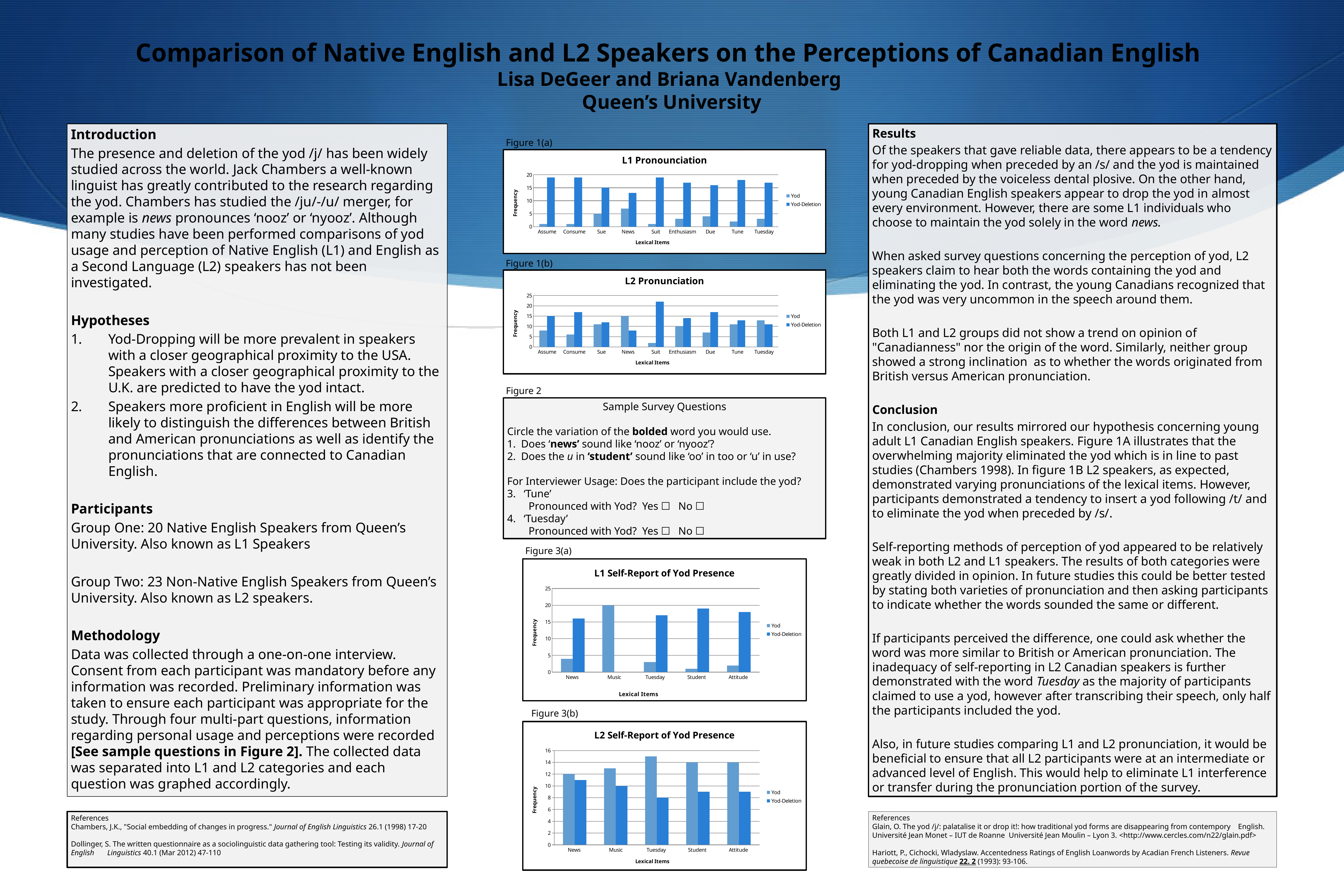
In the L1 Self-Report of Yod Presence chart, which lexical item has the highest Yod value? Music In the L1 Pronounciation chart, how many lexical items are shown on the x axis? 9 In the L2 Pronunciation chart, which lexical item has the highest Yod-Deletion value? Suit In the L1 Self-Report of Yod Presence chart, is the Yod-Deletion value for Student greater or less than 15? greater How many series does the legend of the L2 Self-Report of Yod Presence chart list? 2 In the L1 Pronounciation chart, which lexical item has the highest Yod value? News In the L2 Self-Report of Yod Presence chart, is the Yod-Deletion value for Tuesday greater or less than 10? less In the L1 Pronounciation chart, is the Yod-Deletion value for News greater or less than 15? less In the L2 Pronunciation chart, which lexical item has the lowest Yod value? Suit In the L1 Self-Report of Yod Presence chart, how many lexical items are shown on the x axis? 5 In the L2 Self-Report of Yod Presence chart, which is larger for Tuesday, the Yod value or the Yod-Deletion value? Yod